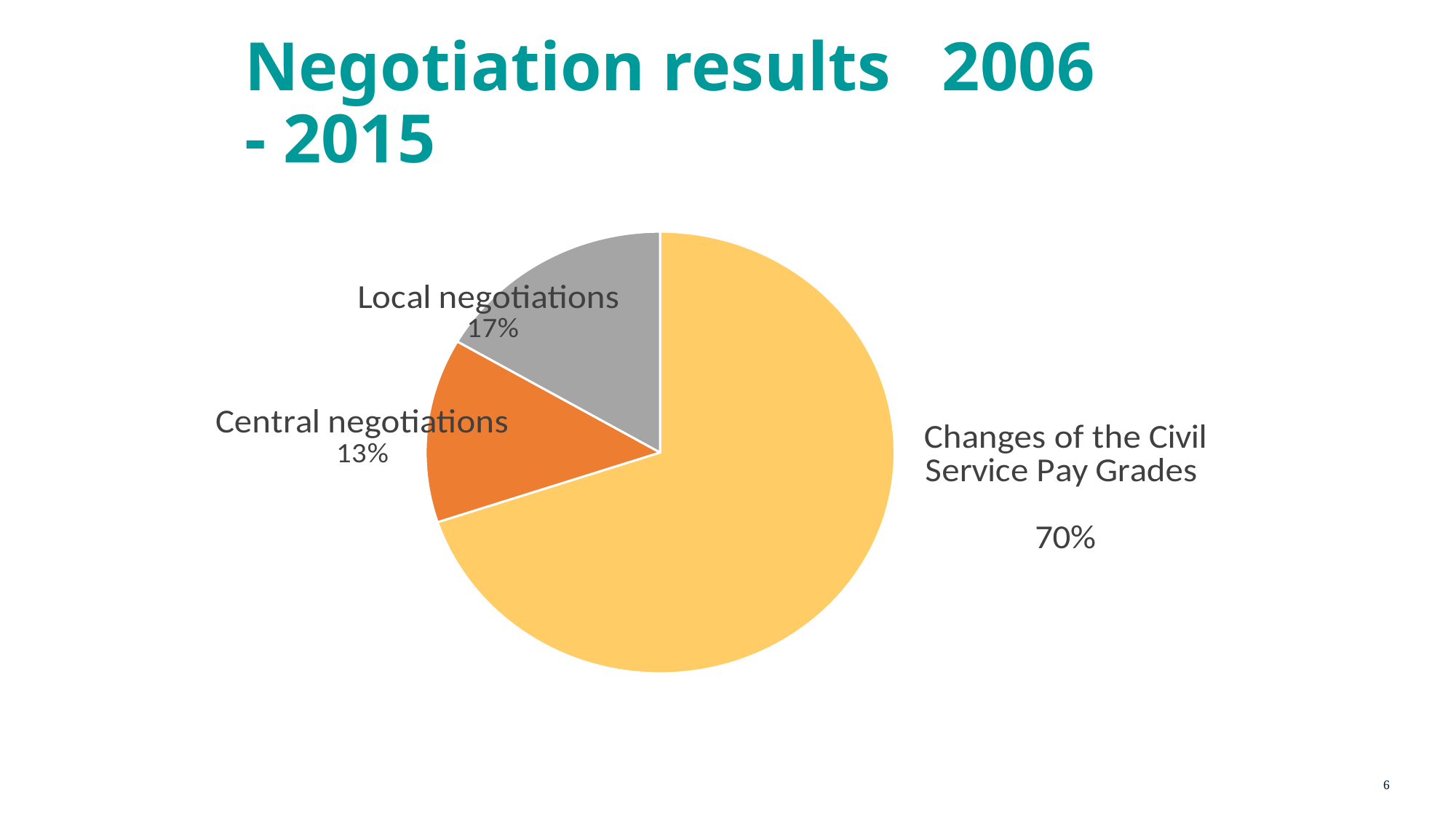
What colour is the Central negotiations slice? orange Which slice of the pie is the smallest? Central negotiations What share of the pie is Changes of the Civil Service Pay Grades? 70% What is the difference in percentage points between Changes of the Civil Service Pay Grades and Local negotiations? 53 percentage points What is the difference in percentage points between Local negotiations and Central negotiations? 4 percentage points What share of the pie is Local negotiations? 17% How many slices does the pie chart have? 3 What kind of chart is shown on the slide? pie chart What is the title of the slide containing the chart? Negotiation results 2006 - 2015 Which slice of the pie is the largest? Changes of the Civil Service Pay Grades What share of the pie is Central negotiations? 13% Which is larger, Local negotiations or Central negotiations? Local negotiations